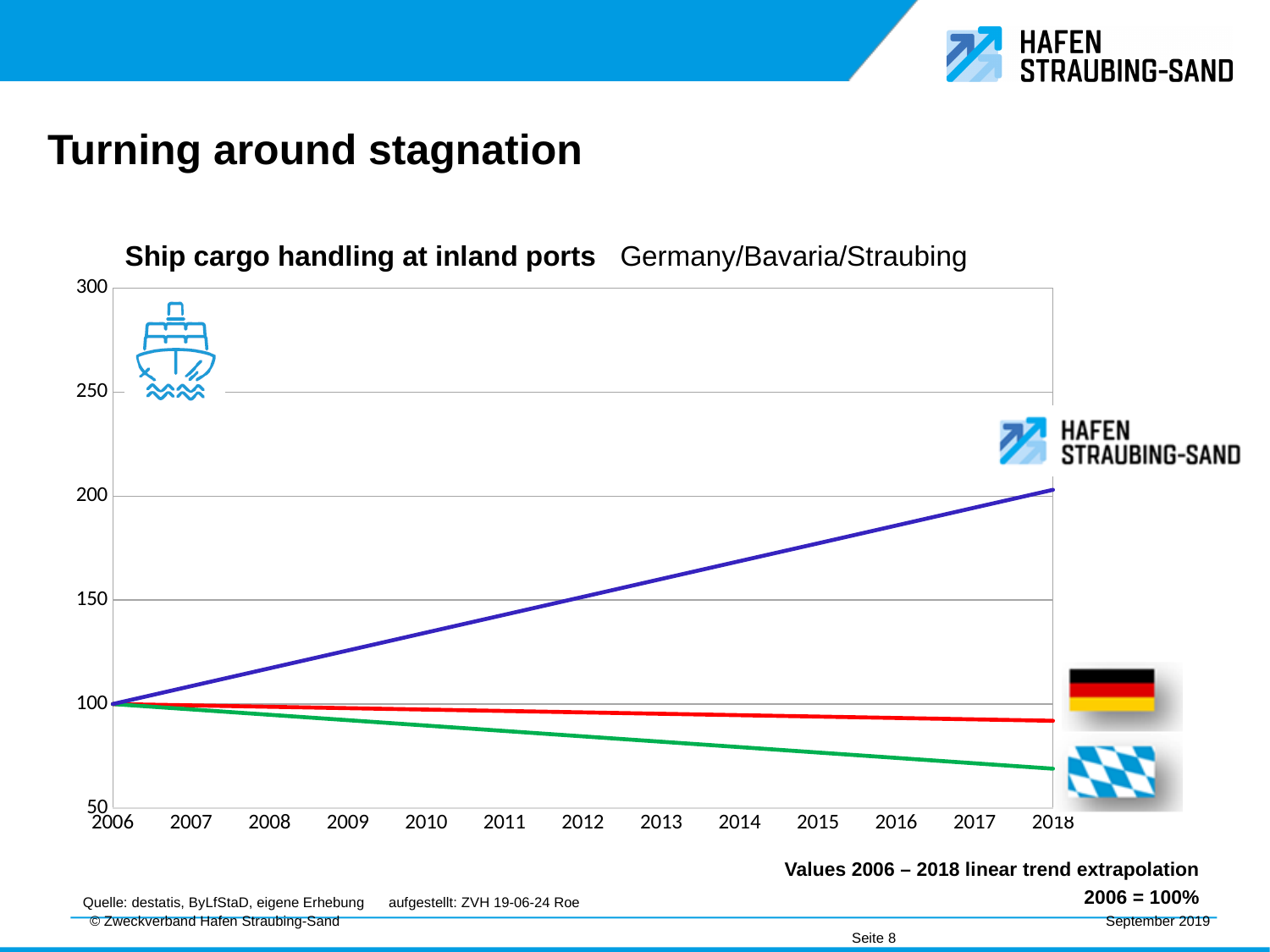
What value do all three lines start at in 2006? 100 Does the green line rise or fall from 2006 to 2018? fall What kind of chart is shown on the slide? line chart Which line has the highest value in 2018? the blue line Which line has the lowest value in 2018? the green line Is the value of the blue line in 2018 greater or less than 150? greater How many years are marked on the x axis of the chart? 13 Is the value of the green line in 2018 greater or less than 100? less What is the title of the chart? Ship cargo handling at inland ports Does the blue line rise or fall from 2006 to 2018? rise How many lines are plotted on the chart? 3 In 2018, which is larger: the value of the red line or the value of the green line? the red line